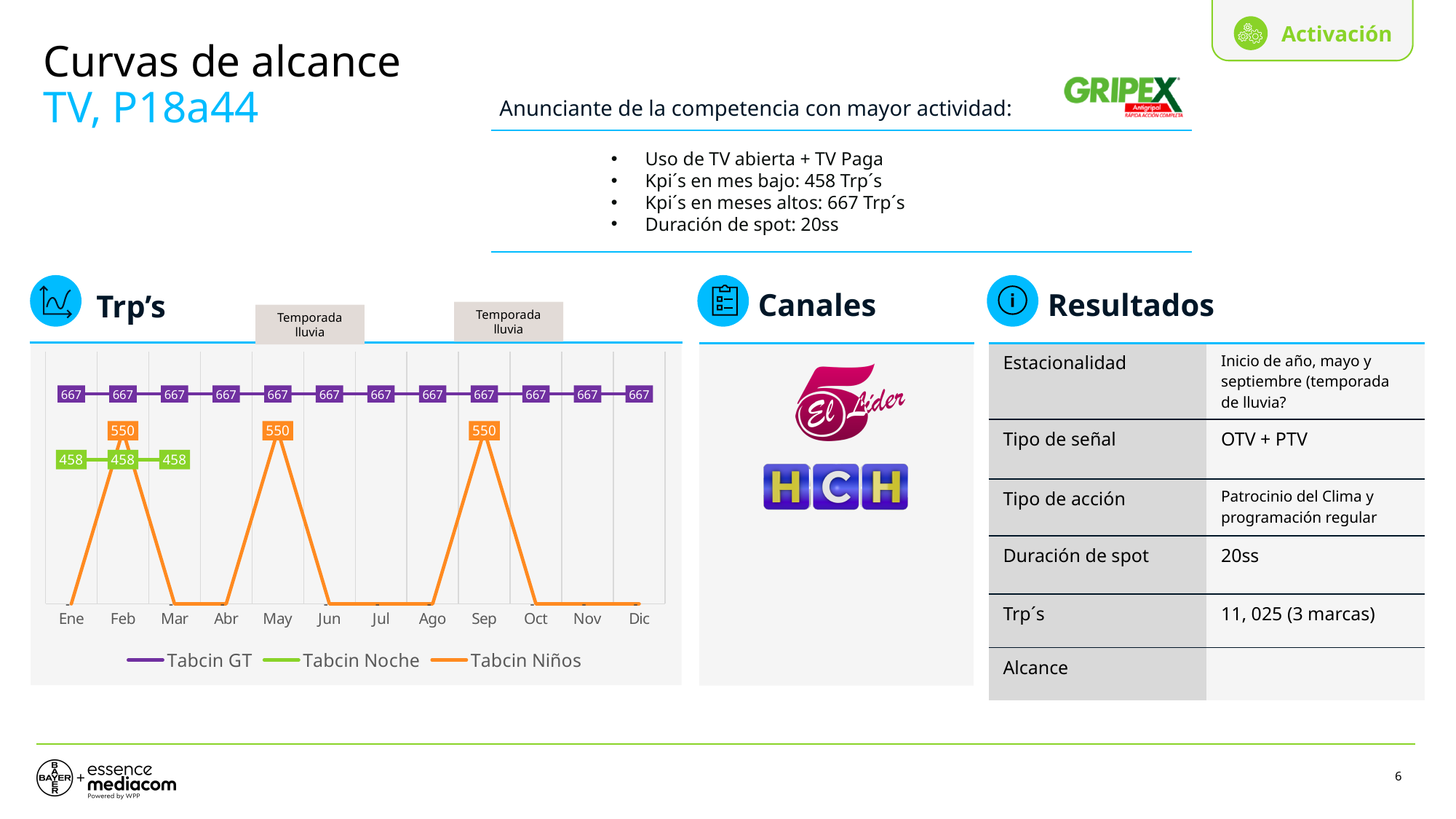
How many series does the legend of the Trp's chart list? 3 What is the difference between Tabcin GT and Tabcin Noche in Ene? 209 In which months does Tabcin Niños reach its peak value of 550? Feb, May, Sep What is the value for Tabcin Niños in May? 550 Does the Tabcin GT line rise, fall, or stay flat across the months? stays flat What is the value for Tabcin Noche in Feb? 458 What is the value for Tabcin GT in Jul? 667 What is the difference between Tabcin Niños and Tabcin Noche in Feb? 92 What kind of chart is shown in the Trp's section? line chart Which series has the higher value in Sep, Tabcin GT or Tabcin Niños? Tabcin GT How many months are shown on the x axis of the Trp's chart? 12 Which series in the Trp's chart is drawn in orange? Tabcin Niños